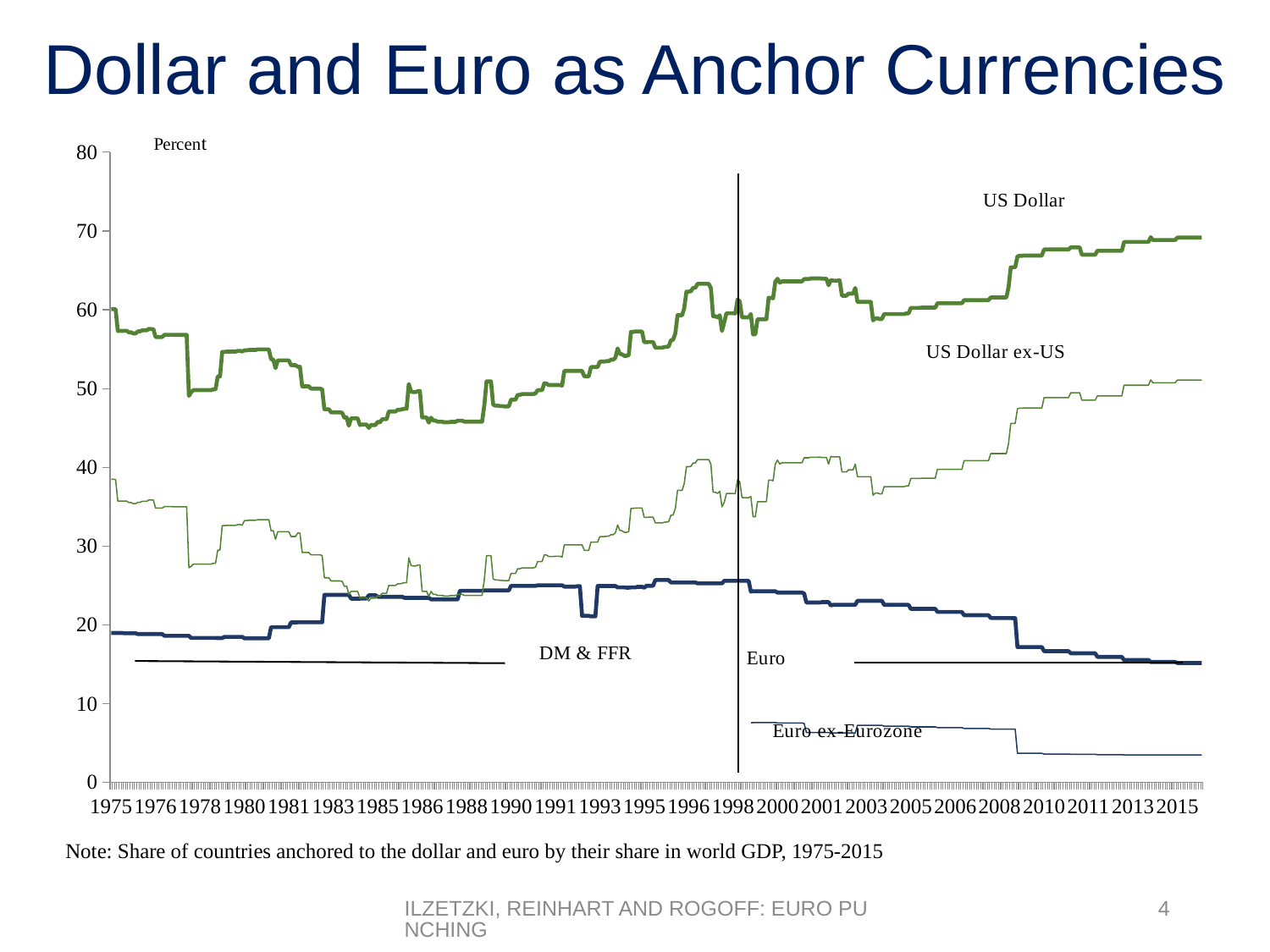
Is the value for Euro ex-Eurozone in 2015 greater or less than 10? less Is the value for US Dollar in 2015 greater or less than 60? greater Which series has the highest values across the whole chart? US Dollar What is the title of the slide's chart? Dollar and Euro as Anchor Currencies Is the value for DM & FFR in 1975 greater or less than 30? less What unit is shown at the top of the vertical axis? Percent How many series are labelled on the chart? 4 Which is larger in 2015, the US Dollar series or the Euro series? US Dollar Which series has the lowest values at the end of the chart in 2015? Euro ex-Eurozone What kind of chart is shown on the slide? line chart Does the Euro series rise or fall between 2000 and 2015? fall